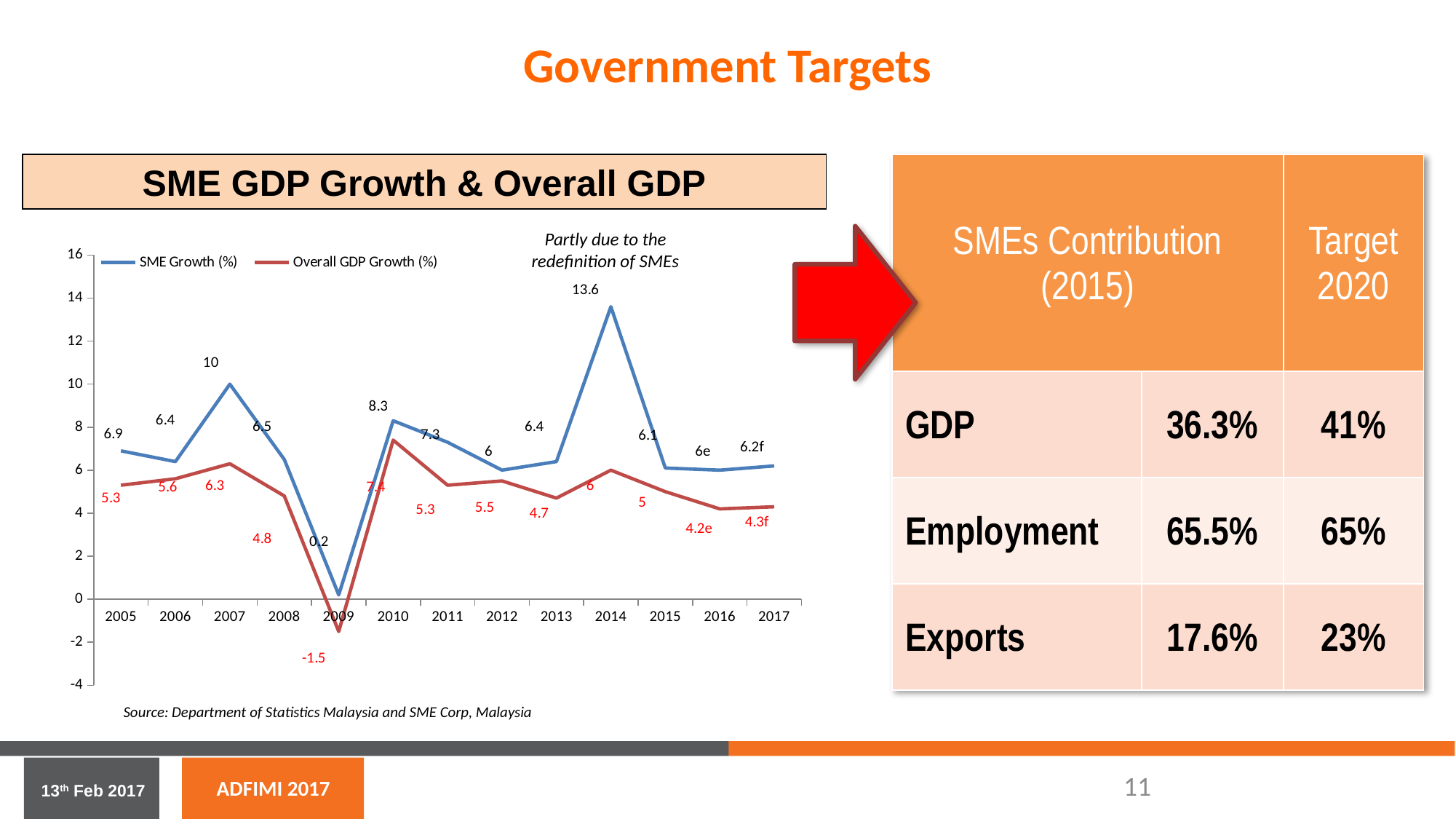
Does SME Growth (%) rise or fall from 2014 to 2015? fall How many series does the chart legend list? 2 What is the Overall GDP Growth (%) value for 2009? -1.5 In which year is Overall GDP Growth (%) lowest? 2009 Which is larger in 2010: SME Growth (%) or Overall GDP Growth (%)? SME Growth (%) What type of chart is shown on the slide? line chart What is the SME Growth (%) value for 2014? 13.6 How many years are plotted on the x axis of the chart? 13 In which year is SME Growth (%) highest? 2014 What is the difference between SME Growth (%) and Overall GDP Growth (%) in 2014? 7.6 What is the title of the chart? SME GDP Growth & Overall GDP What is the SME Growth (%) value for 2007? 10